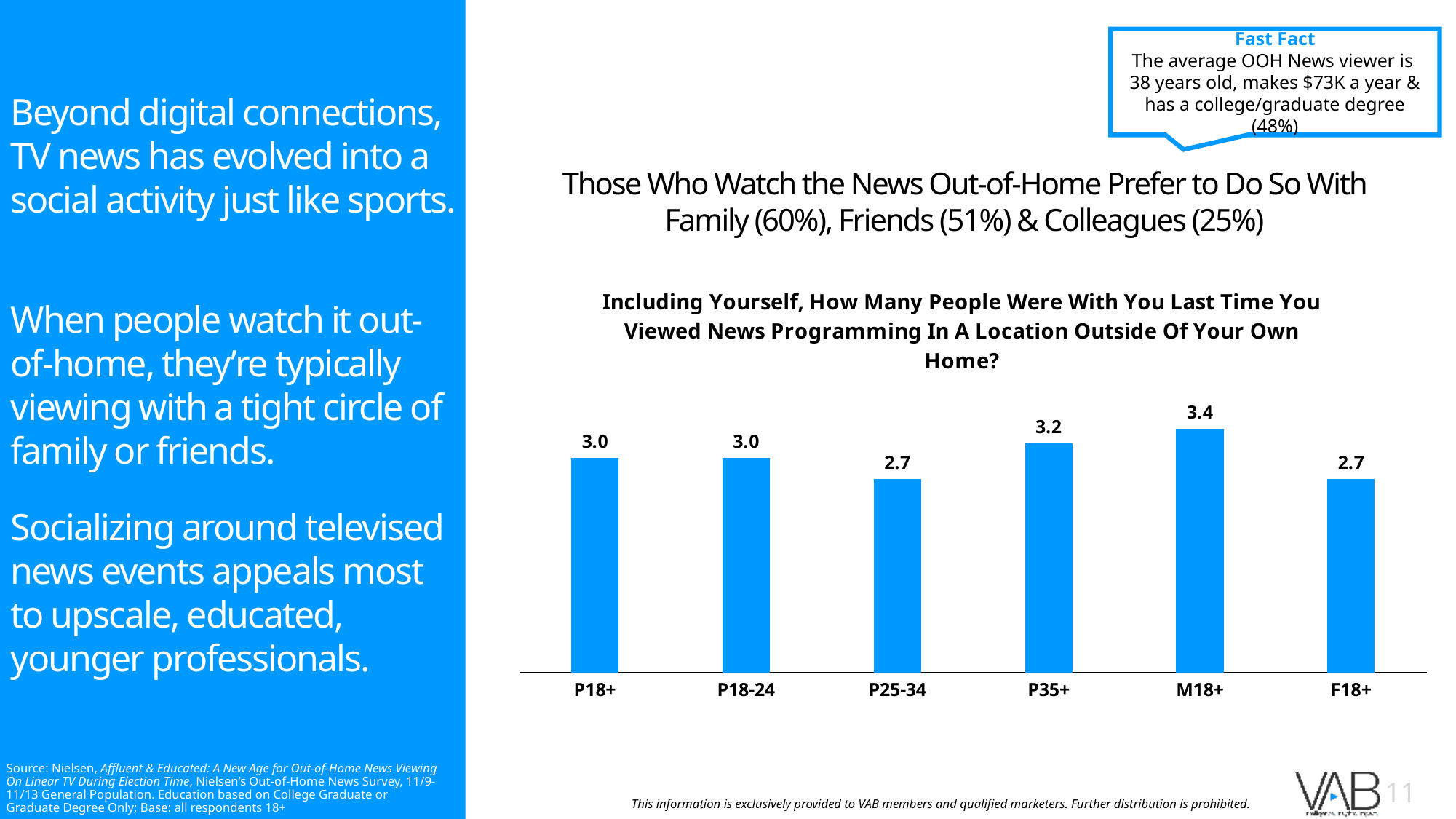
What is the value for P18+? 3.0 What is the value for P25-34? 2.7 How many categories are shown on the x axis? 6 What is the value for M18+? 3.4 Which is larger, the value for M18+ or the value for P18+? M18+ What is the difference between the values for P35+ and P18-24? 0.2 What is the value for P35+? 3.2 What kind of chart is shown? Bar chart Which is larger, the value for P35+ or the value for P25-34? P35+ Which category has the highest value? M18+ What is the title of the chart? Including Yourself, How Many People Were With You Last Time You Viewed News Programming In A Location Outside Of Your Own Home? What is the difference between the values for M18+ and F18+? 0.7